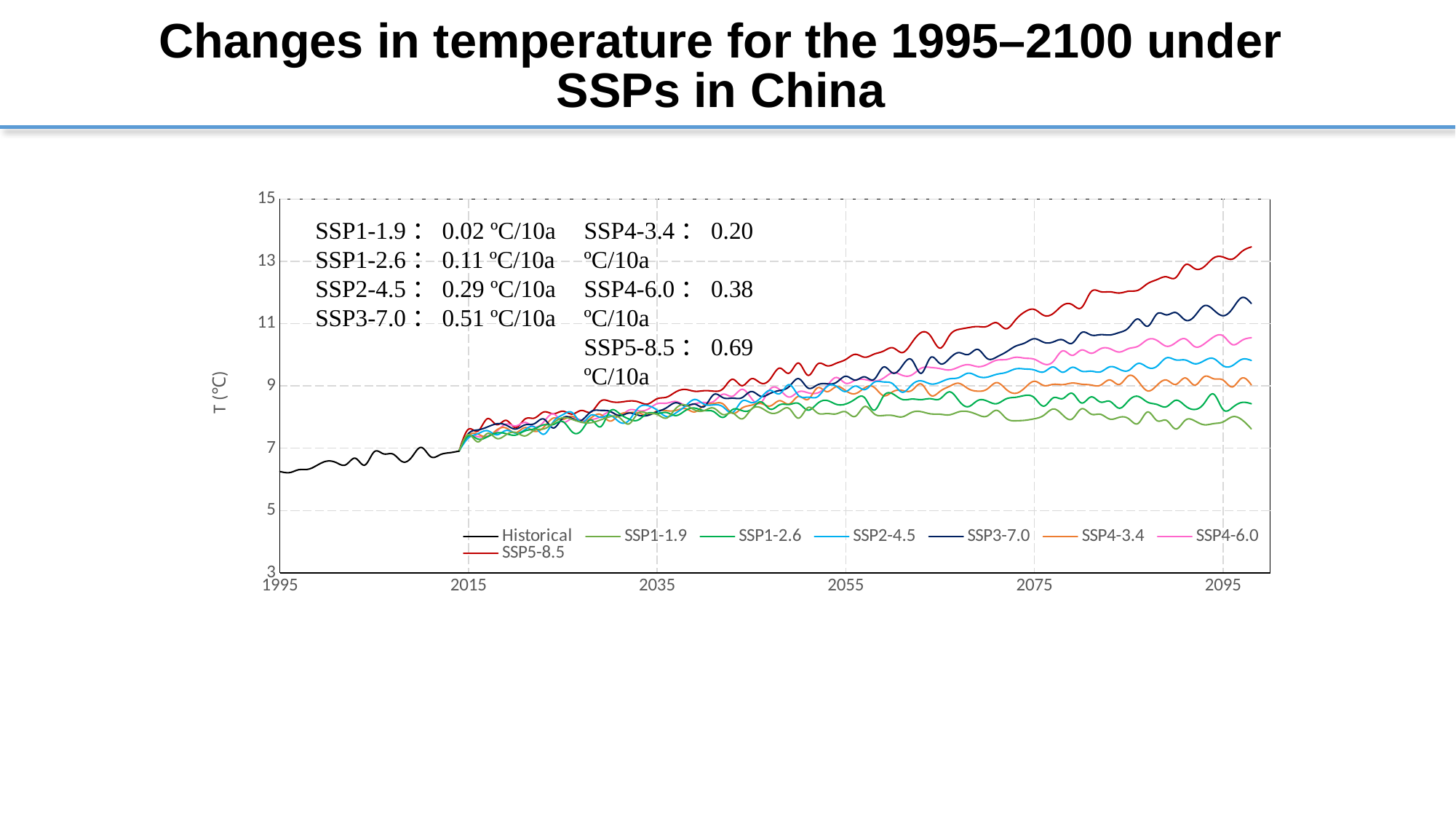
At 2095, which series has the larger value: SSP3-7.0 or SSP4-6.0? SSP3-7.0 According to the text printed on the chart, what is the warming rate for SSP5-8.5? 0.69 ºC/10a How many series does the legend list? 8 Is the value for SSP5-8.5 at 2095 greater or less than 11? greater Does the SSP5-8.5 line rise or fall from 2015 to 2100? rises What kind of chart is shown on the slide? line chart Is the value for SSP1-1.9 at 2095 greater or less than 9? less Which series reaches the highest temperature at the right end of the chart (around 2095)? SSP5-8.5 Which scenario has the lowest warming rate printed on the chart? SSP1-1.9 According to the text printed on the chart, what is the warming rate for SSP3-7.0? 0.51 ºC/10a What is the difference between the printed warming rates of SSP5-8.5 and SSP1-1.9? 0.67 ºC/10a Is the value for the Historical series at 1995 greater or less than 7? less